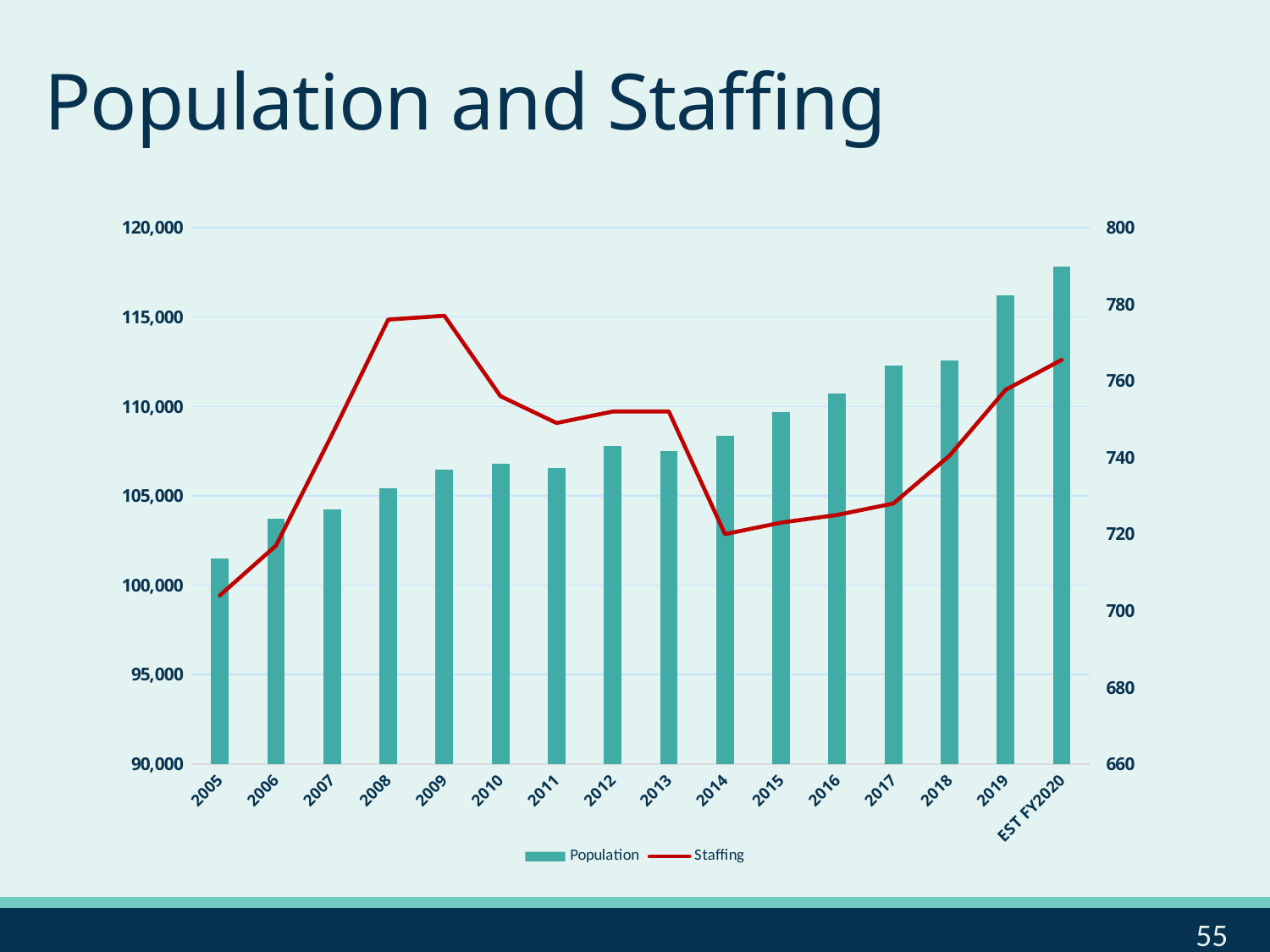
Which category has the lowest Population bar? 2005 Is the Staffing value for 2008 greater or less than 760? greater Is the Population value for 2005 greater or less than 100,000? greater How many series does the legend list? 2 How many categories are shown along the x axis? 16 Is the Population value for 2014 greater or less than 110,000? less Does the Population series generally rise or fall from 2005 to EST FY2020? rise In which year is the Staffing line at its lowest point? 2005 Which category has the highest Population bar? EST FY2020 Which is larger, the Population value for 2015 or for 2016? 2016 What kind of chart is shown on the slide? A combination bar and line chart